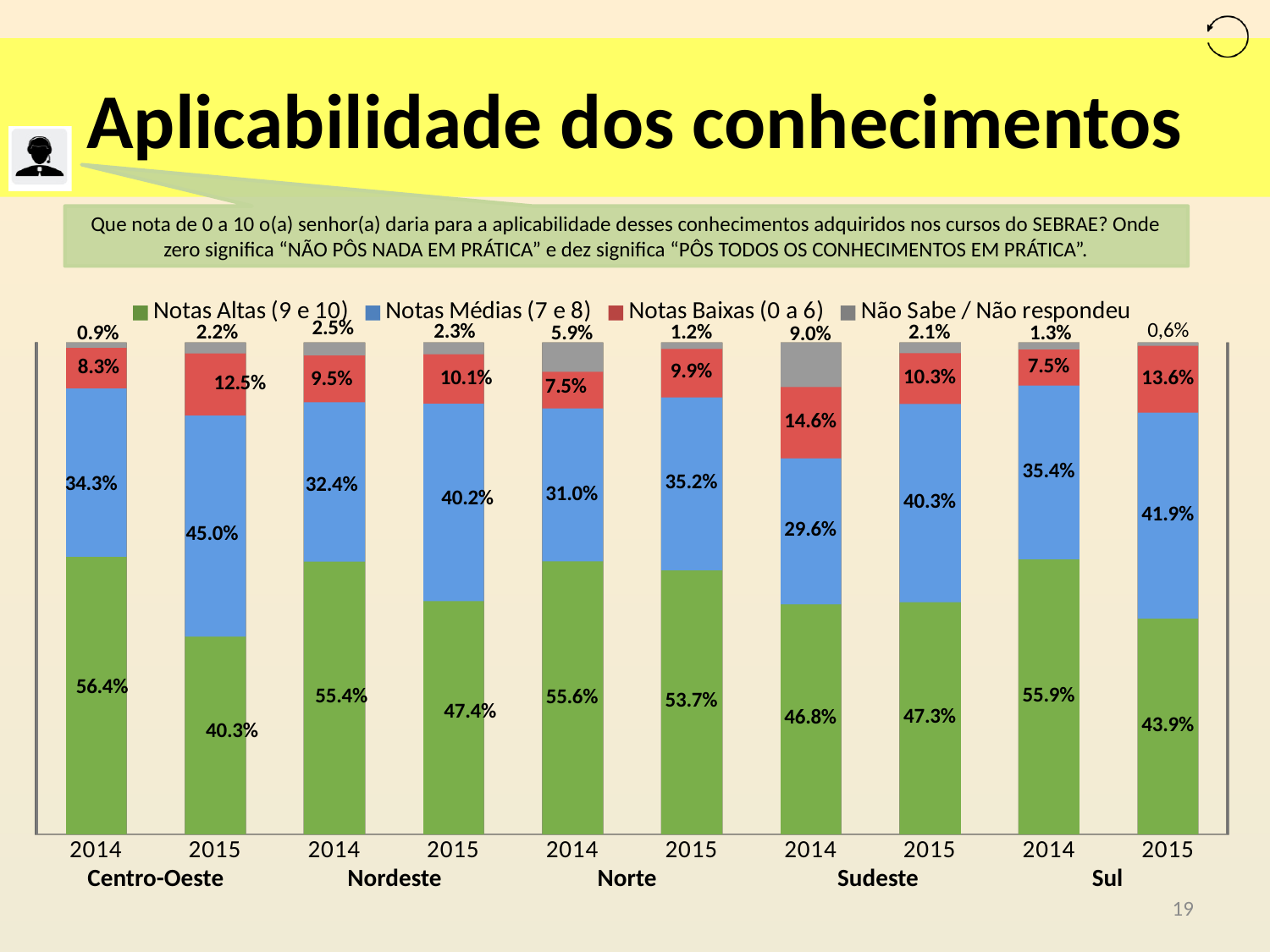
What kind of chart is shown on the slide? Stacked bar chart What is the value of Não Sabe / Não respondeu for Norte in 2014? 5.9% Which is larger: Notas Médias (7 e 8) for Sudeste in 2014 or for Sudeste in 2015? Sudeste 2015 What is the value of Notas Médias (7 e 8) for Sul in 2015? 41.9% What is the value of Notas Baixas (0 a 6) for Sudeste in 2014? 14.6% What is the difference between the Notas Altas (9 e 10) values for Centro-Oeste in 2014 and 2015? 16.1 percentage points Which region and year has the lowest value for Notas Altas (9 e 10)? Centro-Oeste 2015 Did the Notas Altas (9 e 10) value for Sul rise or fall from 2014 to 2015? Fall What is the value of Notas Altas (9 e 10) for Centro-Oeste in 2014? 56.4% How many series does the legend list? 4 How many bars are plotted in the chart? 10 Which region and year has the highest value for Notas Baixas (0 a 6)? Sudeste 2014